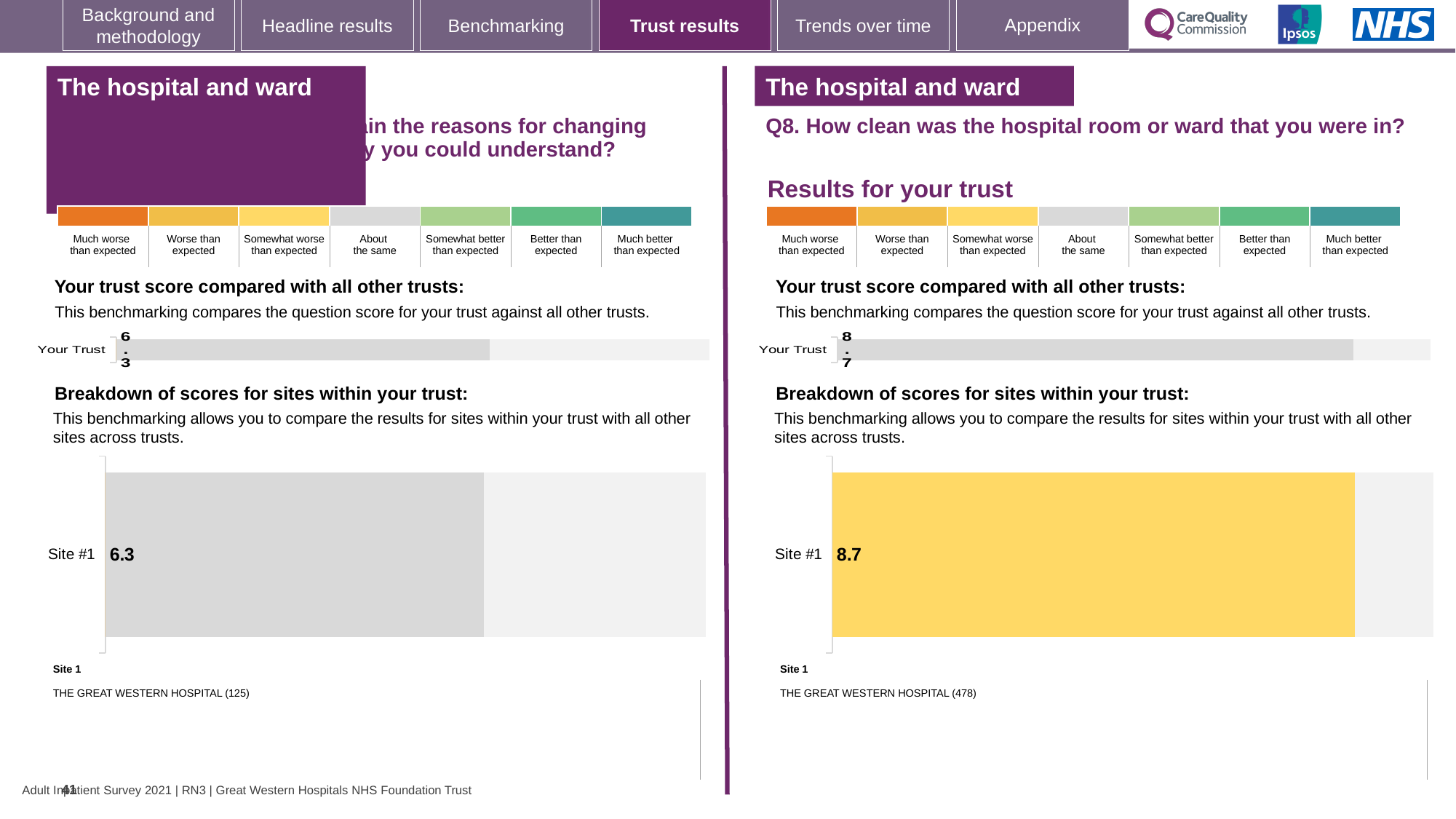
On the left-hand panel, what is the score shown for Site #1 in the breakdown of scores for sites within your trust? 6.3 What colour is the Site #1 bar on the right-hand panel (Q8)? Yellow What type of chart is used to show the Site #1 score on the right-hand panel (Q8)? Bar chart How many sites are shown in the breakdown of scores chart on the right-hand panel (Q8)? 1 On the right-hand panel (Q8), which site name is listed as Site 1? THE GREAT WESTERN HOSPITAL (478) What is the difference between the Site #1 score on the right-hand panel (Q8) and the Site #1 score on the left-hand panel? 2.4 What colour is the Site #1 bar on the left-hand panel? Grey On the left-hand panel, what is the score shown for Your Trust? 6.3 On the right-hand panel (Q8. How clean was the hospital room or ward that you were in?), what is the score shown for Your Trust? 8.7 Which is larger: the Site #1 score on the left-hand panel or the Site #1 score on the right-hand panel (Q8)? Right-hand panel (Q8) How many sites are shown in the breakdown of scores chart on the left-hand panel? 1 On the right-hand panel (Q8), what is the score shown for Site #1 in the breakdown of scores for sites within your trust? 8.7